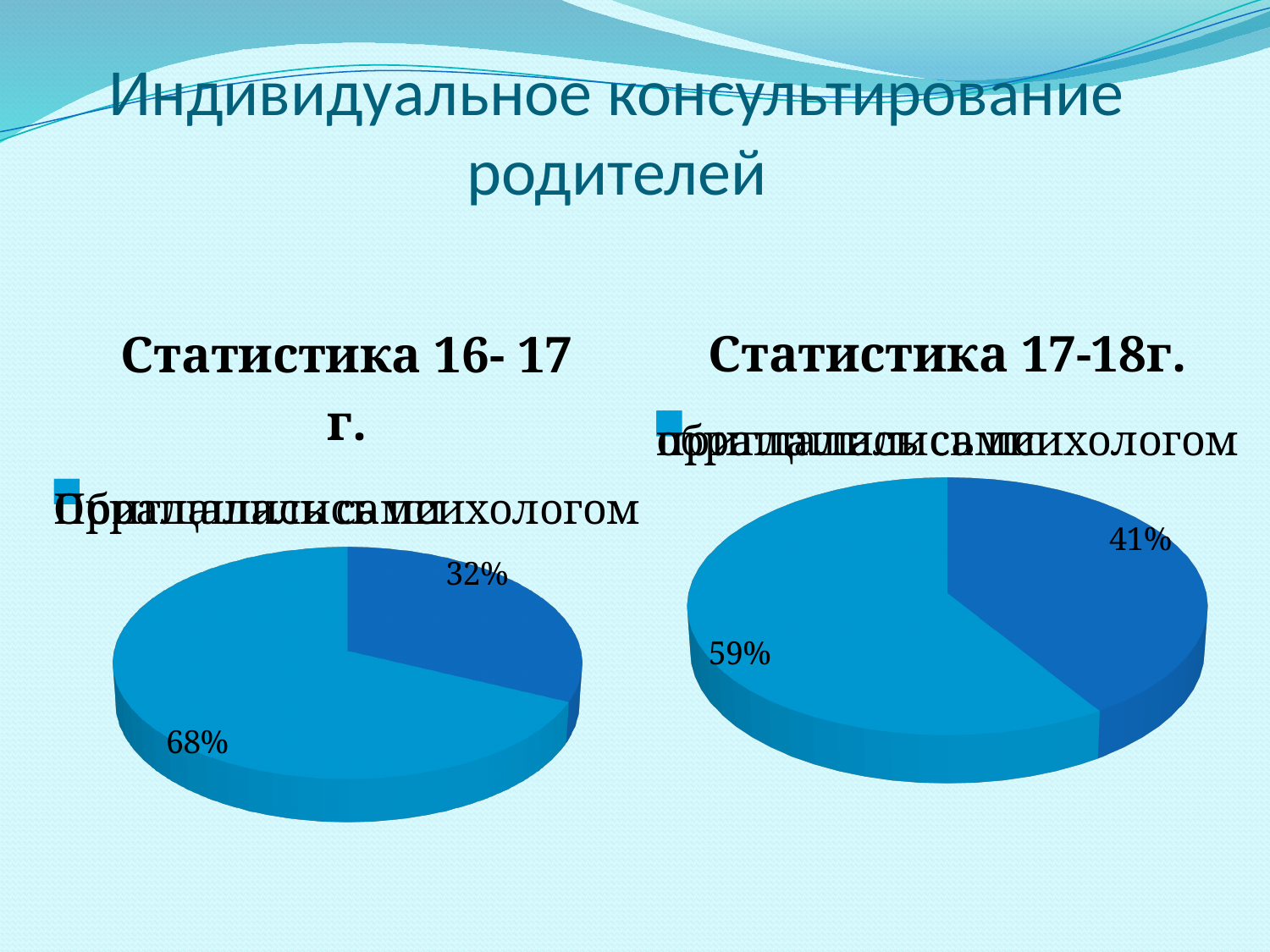
In the "Статистика 16- 17 г." chart, what percentage is shown on the larger slice? 68% In the "Статистика 17-18г." chart, what is the difference in percentage points between the two slices? 18 What type of chart is used for "Статистика 17-18г."? pie chart What type of chart is used for "Статистика 16- 17 г."? pie chart How many slices does the "Статистика 16- 17 г." pie chart have? 2 In the "Статистика 17-18г." chart, what percentage is shown on the smaller slice? 41% In the "Статистика 16- 17 г." chart, what is the difference in percentage points between the two slices? 36 In the "Статистика 17-18г." chart, what percentage is shown on the larger slice? 59% How many pie charts are shown on the slide? 2 Which chart has the larger smaller-slice value, "Статистика 16- 17 г." (32%) or "Статистика 17-18г." (41%)? Статистика 17-18г. In the "Статистика 16- 17 г." chart, what percentage is shown on the smaller slice? 32% How many slices does the "Статистика 17-18г." pie chart have? 2